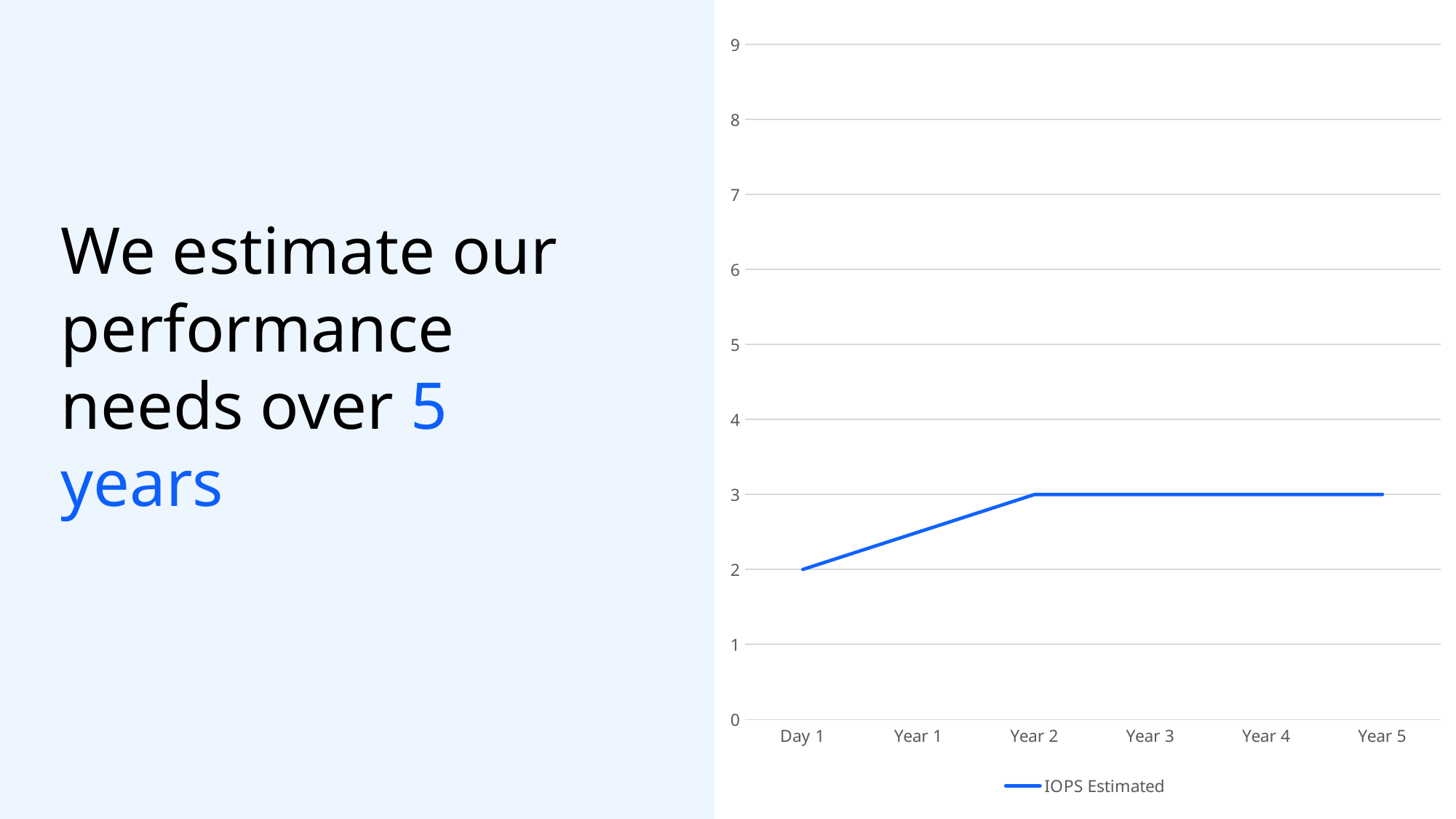
Which is larger, the IOPS Estimated value at Year 2 or at Day 1? Year 2 What is the IOPS Estimated value at Year 5? 3 How many points are plotted along the x axis? 6 What is the name of the series shown in the legend? IOPS Estimated How many series does the legend list? 1 What is the IOPS Estimated value at Year 2? 3 What kind of chart is shown on the slide? line chart Is the IOPS Estimated value at Year 1 greater or less than 2? greater What is the IOPS Estimated value at Day 1? 2 Is the IOPS Estimated value at Year 3 greater or less than 5? less Which point has the lowest IOPS Estimated value? Day 1 What is the difference between the IOPS Estimated value at Year 5 and at Day 1? 1